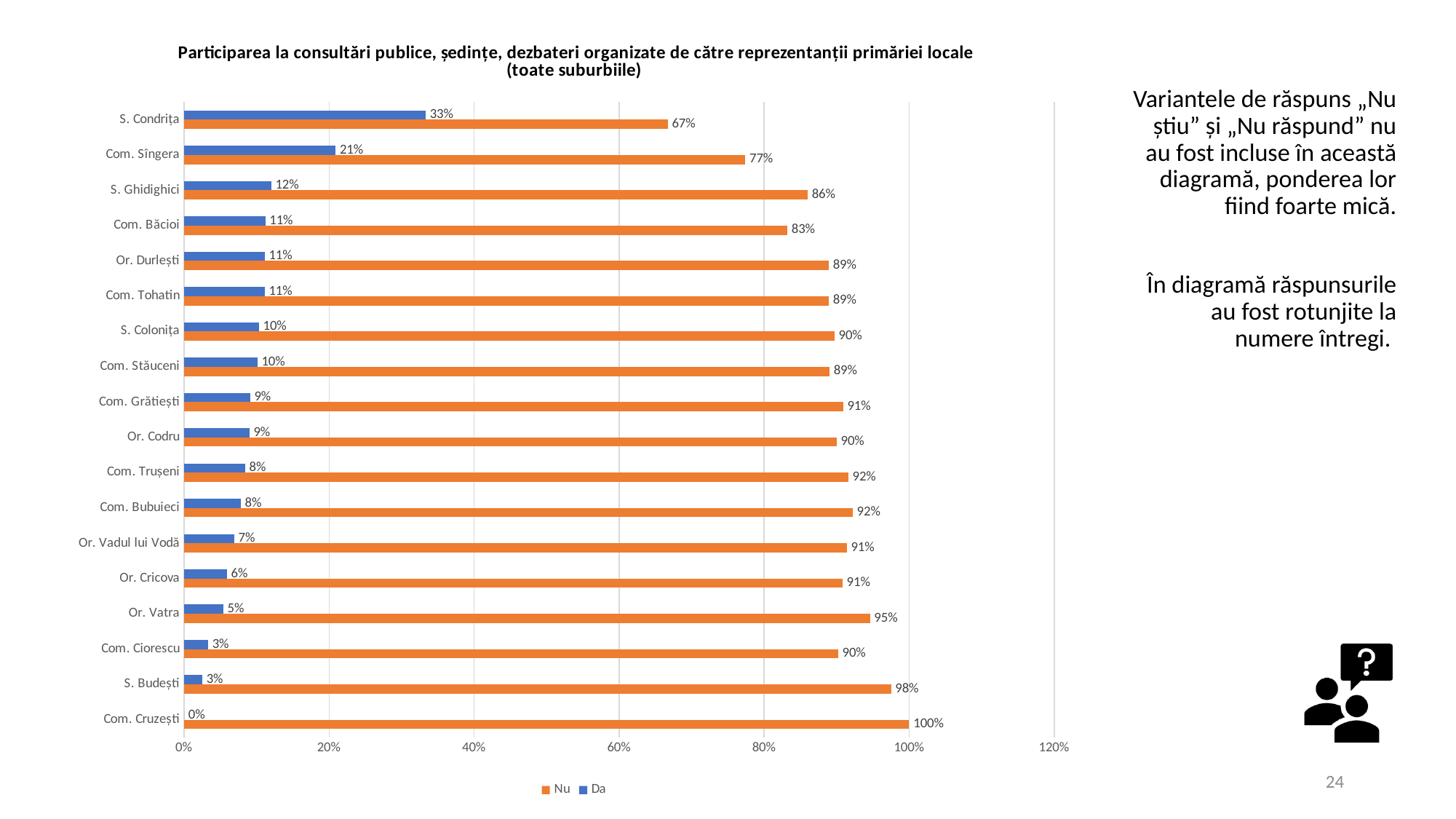
Which category has the highest "Nu" value? Com. Cruzești How many series does the legend list? 2 What type of chart is shown on the slide? Bar chart Which colour represents the "Nu" series? Orange What is the "Da" value for S. Condrița? 33% What is the difference between the "Nu" and "Da" values for Com. Sîngera? 56% Which category has the lowest "Nu" value? S. Condrița How many categories (localities) are shown on the chart? 18 Which category has the highest "Da" value? S. Condrița What is the "Nu" value for Com. Sîngera? 77% What is the "Nu" value for S. Budești? 98% Which is larger: the "Da" value for S. Ghidighici or the "Da" value for Or. Vatra? S. Ghidighici